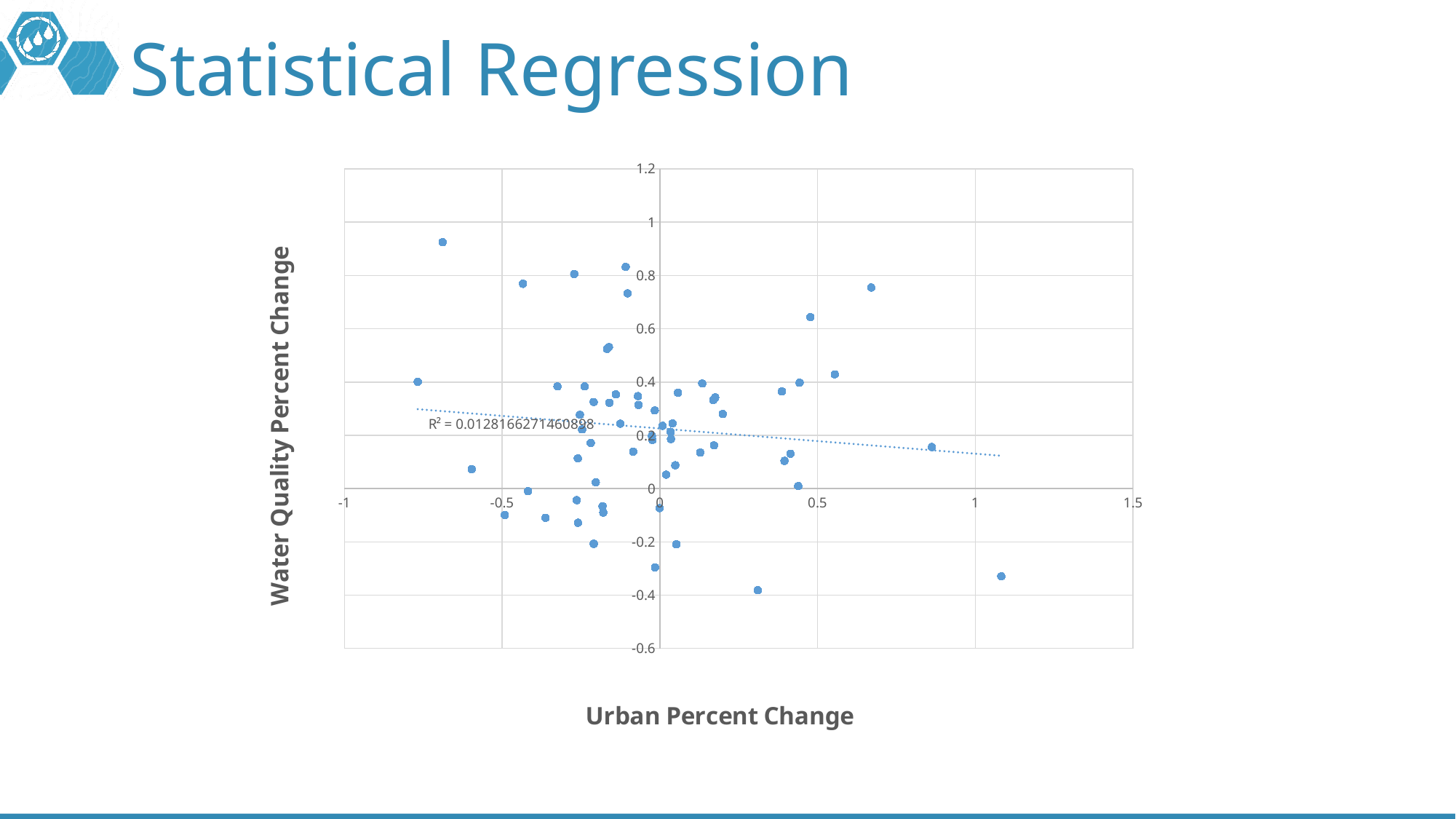
What is the title of the vertical axis of the chart? Water Quality Percent Change Does the dotted trend line rise or fall as Urban Percent Change increases? fall What kind of chart is shown on the slide? scatter chart Is the Water Quality Percent Change of the point with the largest Urban Percent Change greater or less than 0? less Is the Water Quality Percent Change of the lowest point on the chart greater or less than -0.2? less What R² value is printed on the chart for the trend line? R² = 0.0128166271460898 What is the title of the horizontal axis of the chart? Urban Percent Change Is the Water Quality Percent Change of the highest point on the chart greater or less than 0.8? greater